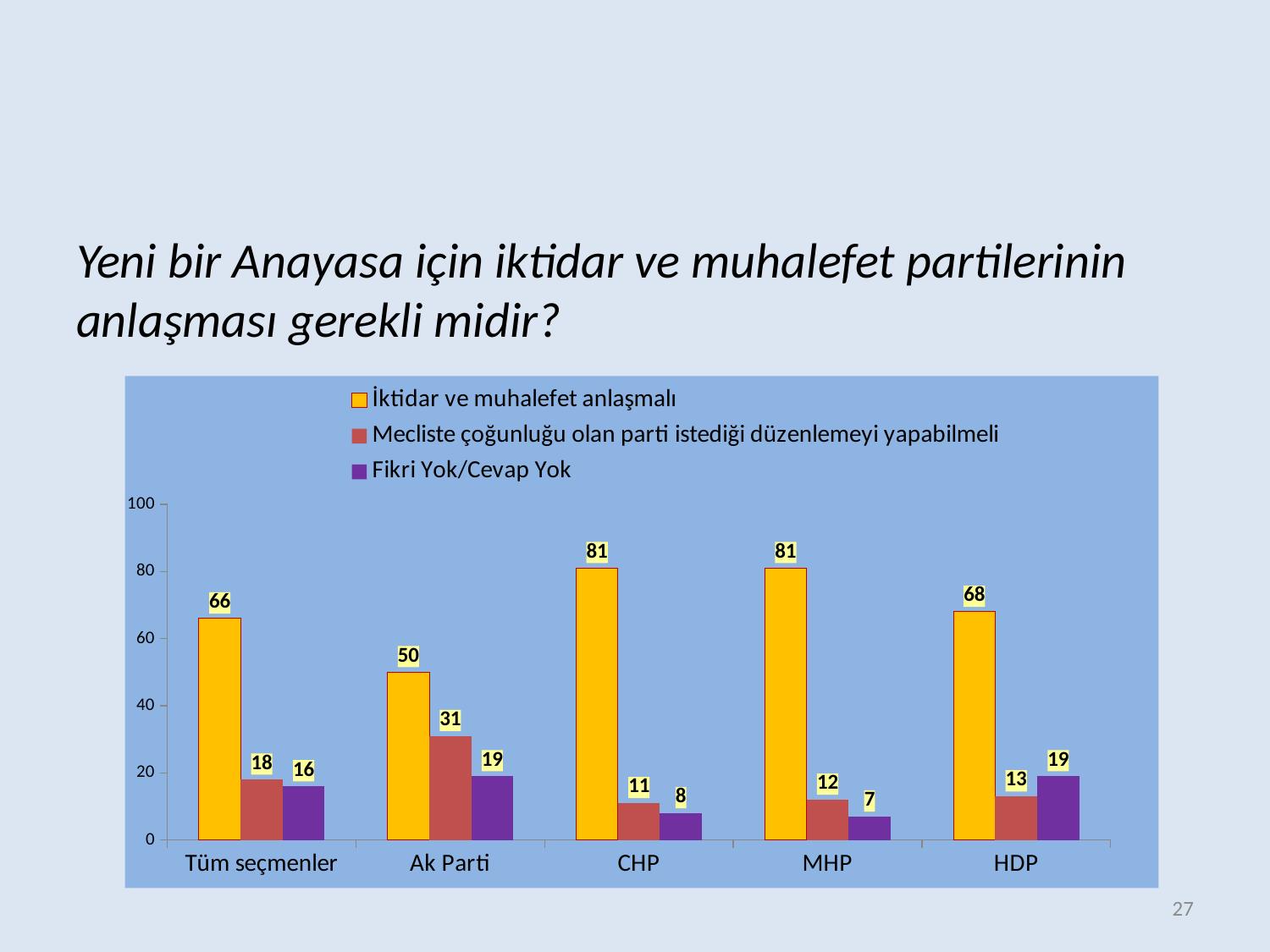
What colour are the bars for "Fikri Yok/Cevap Yok"? Purple What is the value of "Fikri Yok/Cevap Yok" for MHP? 7 How many categories are shown on the x axis? 5 How many series does the legend list? 3 What is the value of "İktidar ve muhalefet anlaşmalı" for Tüm seçmenler? 66 Which category has the highest value for "Mecliste çoğunluğu olan parti istediği düzenlemeyi yapabilmeli"? Ak Parti What kind of chart is shown on the slide? Bar chart What is the difference between the "İktidar ve muhalefet anlaşmalı" values for CHP and HDP? 13 What is the difference between the "Mecliste çoğunluğu olan parti istediği düzenlemeyi yapabilmeli" and "Fikri Yok/Cevap Yok" values for Tüm seçmenler? 2 Which category has the lowest value for "İktidar ve muhalefet anlaşmalı"? Ak Parti What is the value of "Mecliste çoğunluğu olan parti istediği düzenlemeyi yapabilmeli" for Ak Parti? 31 Which is larger: the "Fikri Yok/Cevap Yok" value for Ak Parti or for CHP? Ak Parti